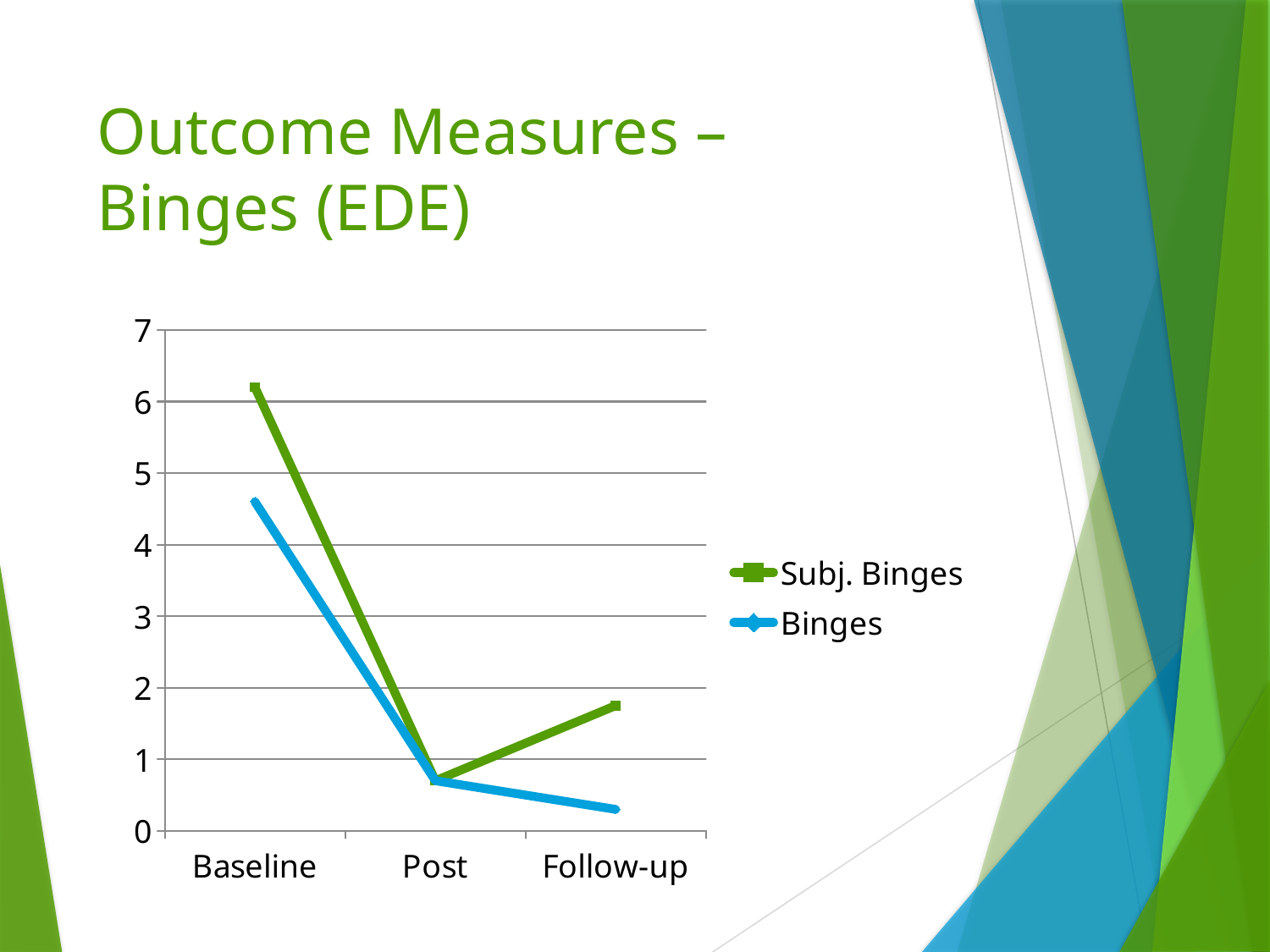
Is the value for Binges at Follow-up greater or less than 1? less Is the value for Subj. Binges at Follow-up greater or less than 2? less How many categories are shown on the x axis? 3 How many series does the legend list? 2 Does the Binges series rise or fall from Baseline to Follow-up? fall At Follow-up, which series has the larger value, Subj. Binges or Binges? Subj. Binges At which time point is the Binges series lowest? Follow-up What kind of chart is shown on the slide? line chart At which time point is the Subj. Binges series highest? Baseline Is the value for Binges at Baseline greater or less than 5? less At Baseline, which series has the larger value, Subj. Binges or Binges? Subj. Binges